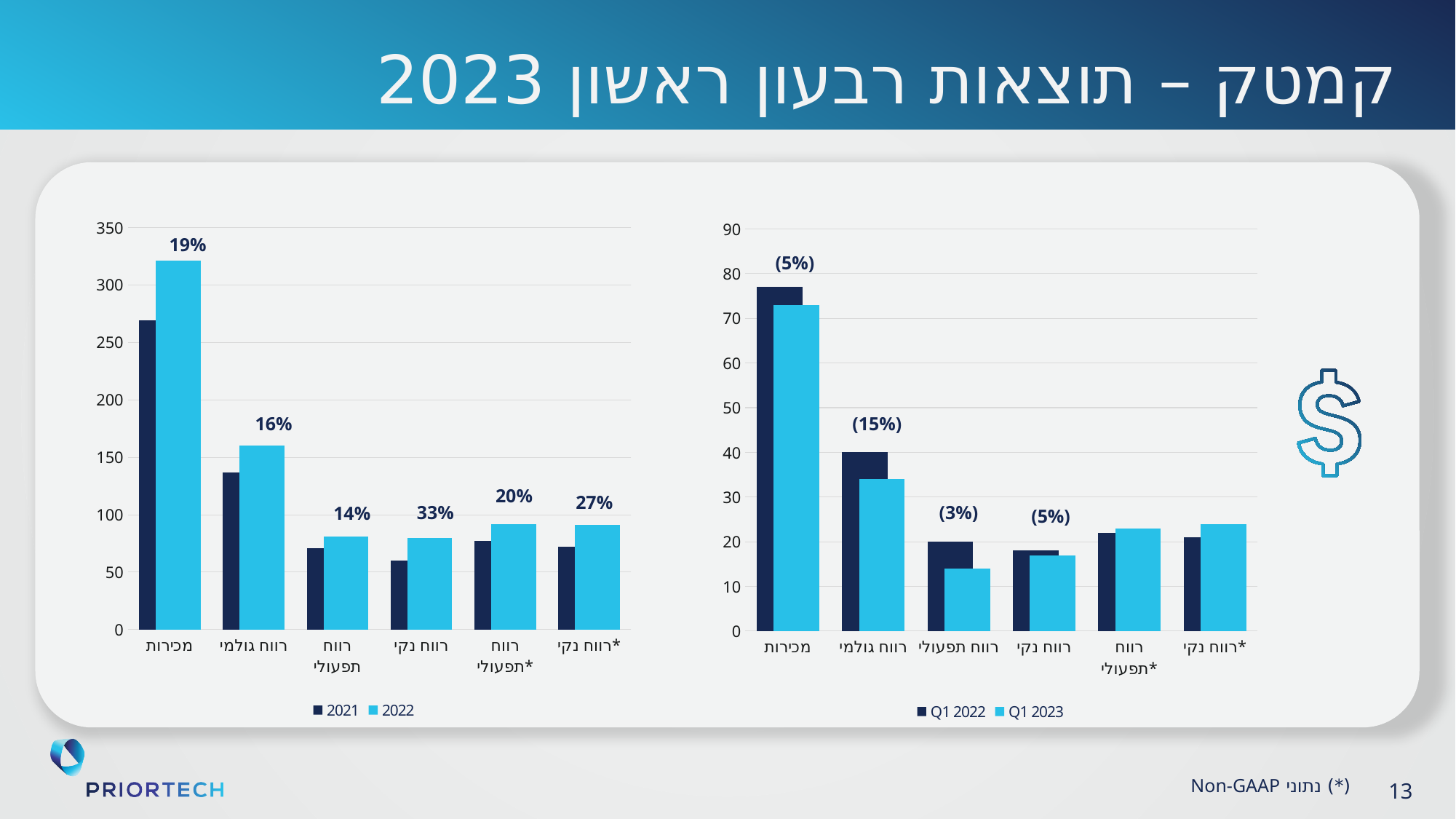
In the left chart, which category has the highest 2022 value? מכירות In the right chart, is the Q1 2023 value for רווח גולמי greater or less than 40? less In the right chart, what percentage label is shown above the מכירות bars? (5%) How many series does the legend of the right chart list? 2 What are the two legend entries of the left chart? 2021 and 2022 In the left chart, what percentage label is shown above the מכירות bars? 19% In the right chart, what percentage label is shown above the רווח גולמי bars? (15%) What kind of chart is the left chart on the slide? bar chart In the right chart, which is larger for מכירות: Q1 2022 or Q1 2023? Q1 2022 In the left chart, what percentage label is shown above the רווח נקי bars? 33% In the left chart, is the 2022 value for מכירות greater or less than 300? greater How many categories are shown on the x axis of the left chart? 6